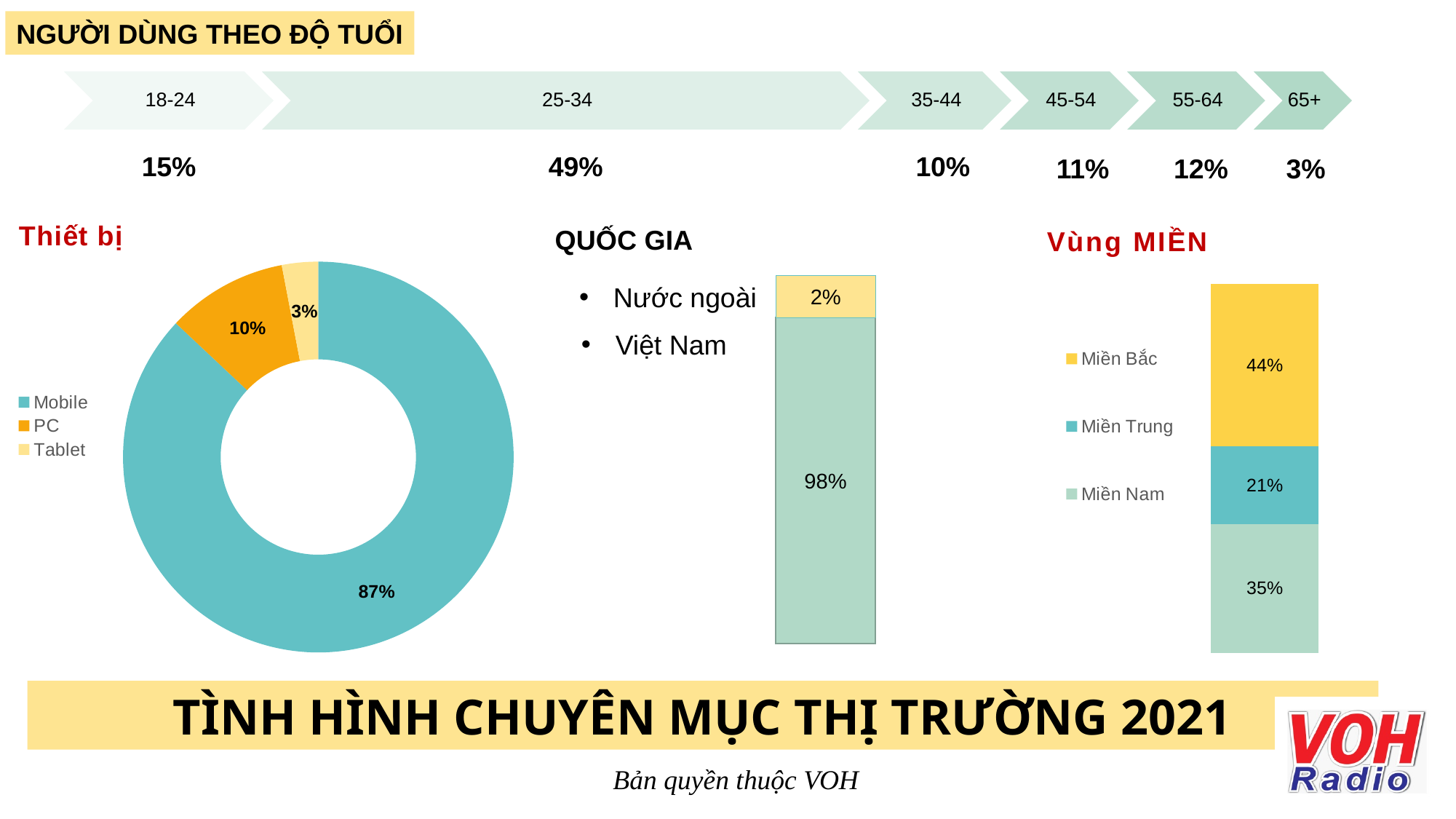
In the "Thiết bị" chart, what percentage is shown for PC? 10% In the "Thiết bị" chart, what is the difference between the Mobile and PC shares? 77% How many entries does the legend of the "Thiết bị" chart list? 3 In the "QUỐC GIA" chart, what percentage is shown for Việt Nam? 98% In the "Vùng MIỀN" chart, which is larger, Miền Nam or Miền Trung? Miền Nam What kind of chart is the "Thiết bị" chart? Doughnut chart In the "Thiết bị" chart, what percentage is shown for Mobile? 87% In the "QUỐC GIA" chart, what percentage is shown for Nước ngoài? 2% In the "Vùng MIỀN" chart, which region has the lowest percentage? Miền Trung In the "Thiết bị" chart, which device has the smallest share? Tablet In the "Vùng MIỀN" chart, what percentage is shown for Miền Bắc? 44% In the "Vùng MIỀN" chart, what is the difference between Miền Bắc and Miền Nam? 9%